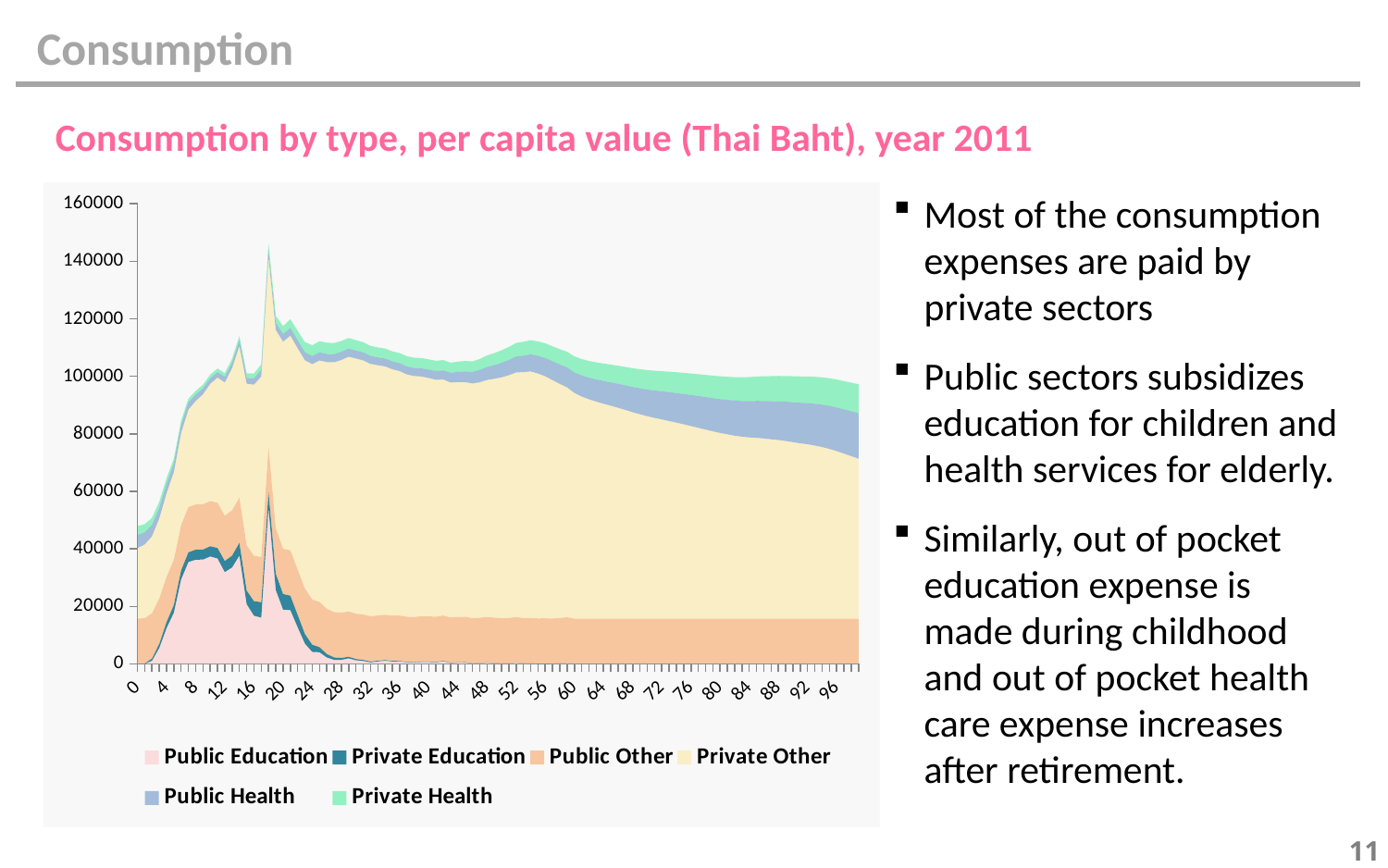
Which series is plotted at the bottom of the stack? Public Education Is the total consumption at age 0 greater or less than 60000? less How many series does the legend list? 6 Is the Public Education value at age 8 greater or less than 20000? greater Does total consumption rise or fall between age 60 and age 96? fall What is the highest value shown on the vertical axis? 160000 What kind of chart is shown on the slide? Stacked area chart Is the peak total consumption (around age 18) greater or less than 120000? greater Does total consumption rise or fall between age 0 and age 8? rise Which series accounts for the largest share of consumption across most ages? Private Other What is the title of the chart? Consumption by type, per capita value (Thai Baht), year 2011